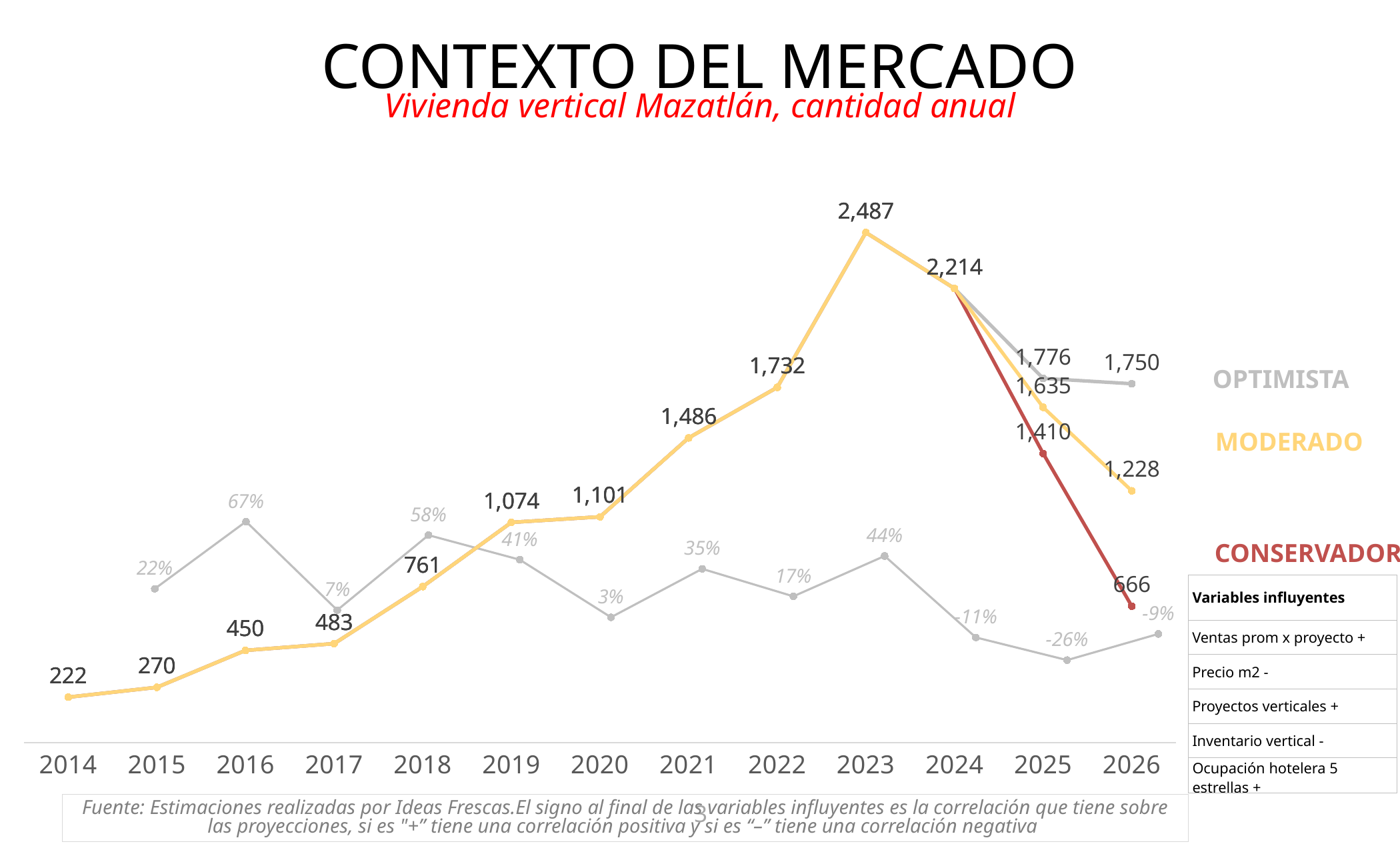
What is the 2026 value for the CONSERVADOR scenario? 666 What is the 2025 value for the MODERADO scenario? 1,635 What is the difference between the 2023 value and the 2024 value? 273 Which is larger, the value for 2019 or the value for 2020? 2020 What is the difference between the OPTIMISTA and CONSERVADOR values for 2026? 1,084 What is the value for 2014? 222 What is the 2026 value for the OPTIMISTA scenario? 1,750 What percentage is shown for 2016 on the grey percentage line? 67% What is the value for 2023? 2,487 Which year has the highest value on the main line? 2023 How many scenarios are labelled on the right of the chart? 3 What kind of chart is shown on the slide? line chart